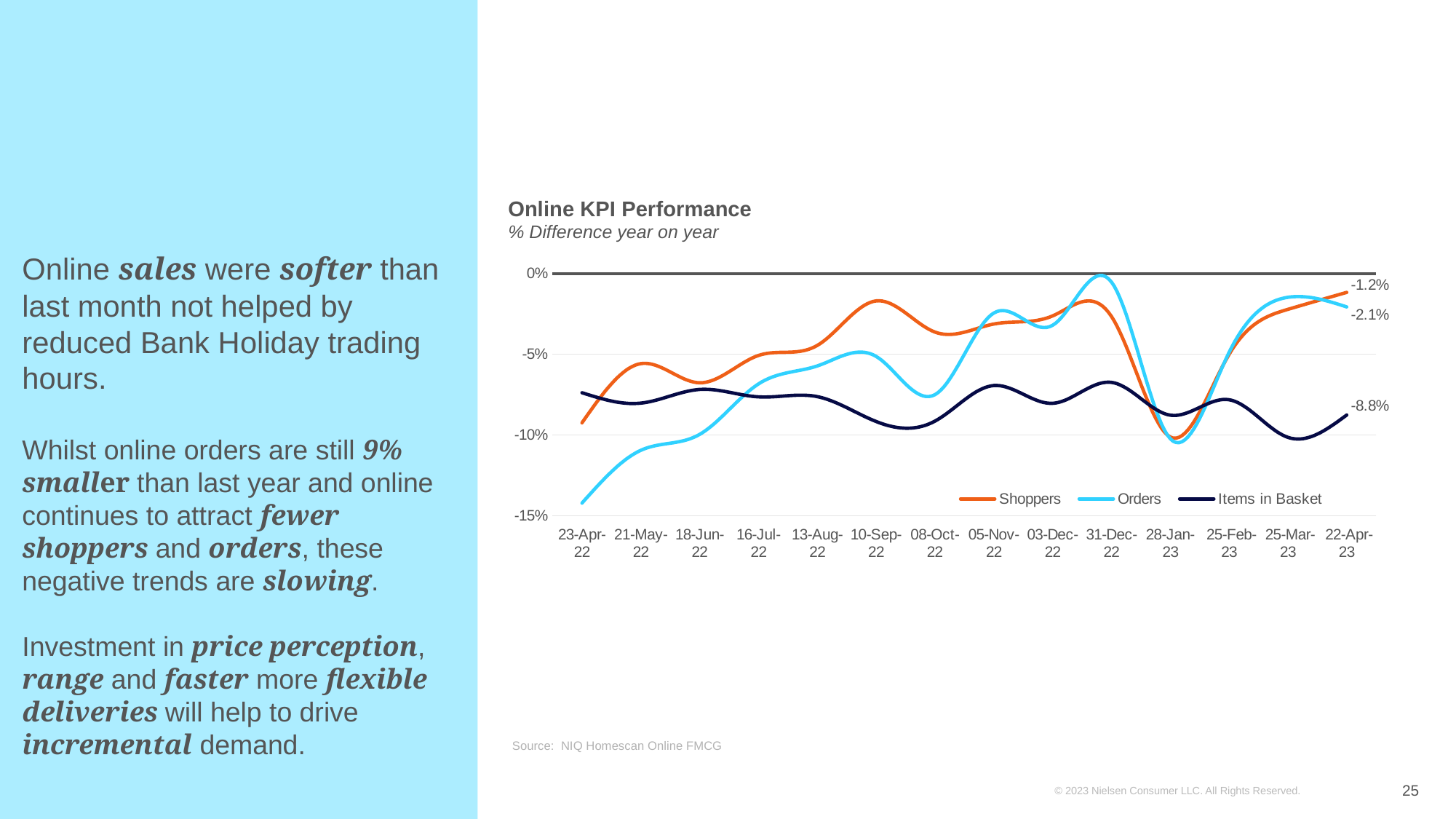
Which series has the lowest value at 22-Apr-23? Items in Basket At 22-Apr-23, what is the difference between the Shoppers value and the Items in Basket value? 7.6 percentage points Is the value for Orders at 23-Apr-22 greater or less than -10%? less Is the value for Items in Basket at 23-Apr-22 greater or less than -10%? greater What is the value for Orders at 22-Apr-23? -2.1% What is the value for Shoppers at 22-Apr-23? -1.2% At 22-Apr-23, which is higher: Shoppers or Orders? Shoppers What is the subtitle shown under the chart title Online KPI Performance? % Difference year on year How many dates are shown on the x axis of the Online KPI Performance chart? 14 What is the value for Items in Basket at 22-Apr-23? -8.8% What type of chart is shown on the slide? Line chart How many series does the legend of the Online KPI Performance chart list? 3